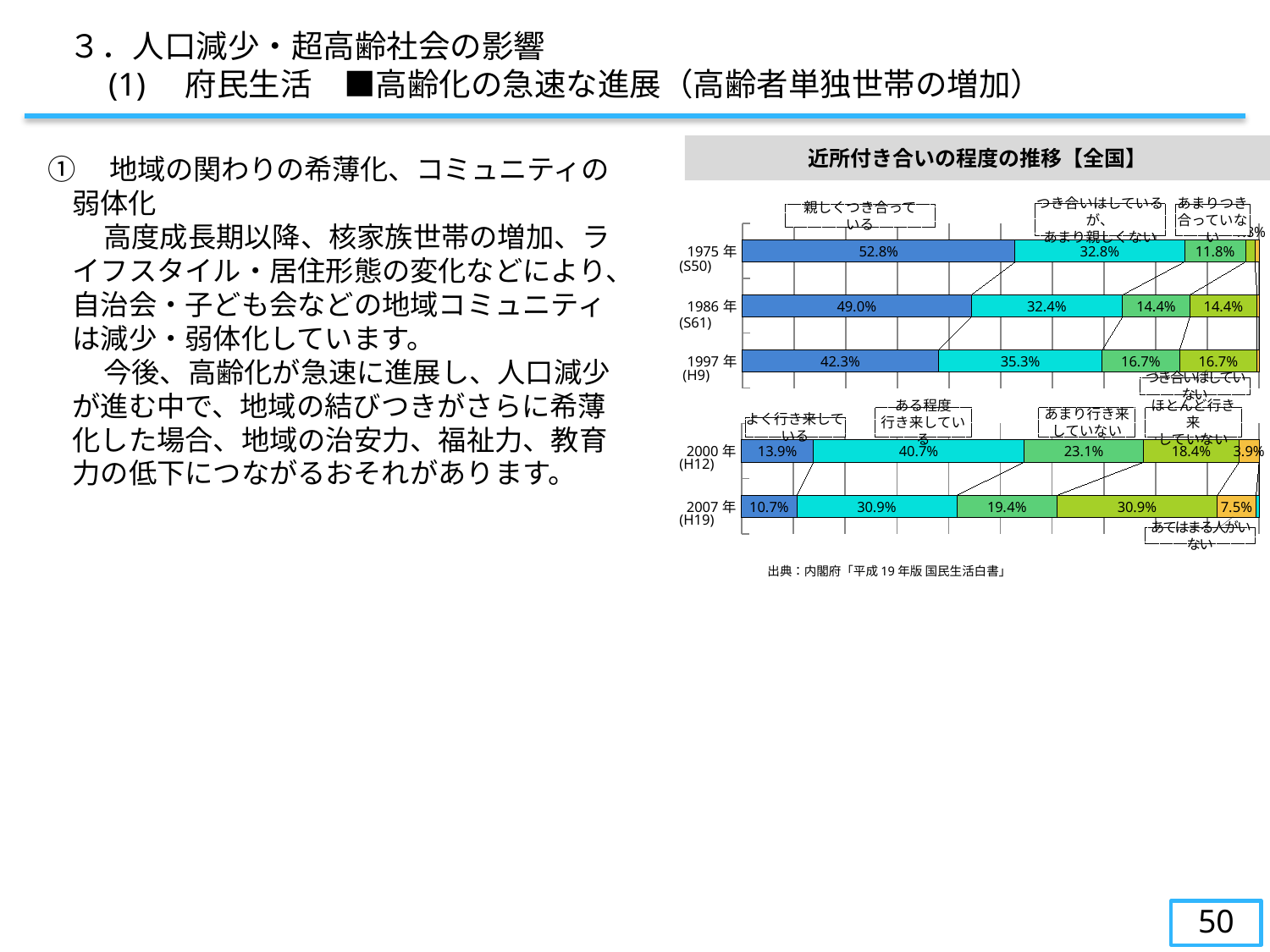
What is the title of the chart on the slide? 近所付き合いの程度の推移【全国】 What is the value of the first (leftmost) segment for 2007年(H19)? 10.7% What is the difference between the first segment for 1975年(S50) (52.8%) and for 1986年(S61) (49.0%)? 3.8% Which is larger: the third segment for 2000年(H12) or the third segment for 2007年(H19)? 2000年(H12) What is the value of the first (leftmost) segment for 1986年(S61)? 49.0% How many years (categories) are shown in the chart? 5 What type of chart is shown on the slide? stacked bar chart What is the value of the second segment for 2000年(H12)? 40.7% How does the first (leftmost) segment change from 1975年 to 1997年? falls What is the value of the first (leftmost) segment for 1975年(S50)? 52.8% What is the value of the second segment for 1997年(H9)? 35.3%